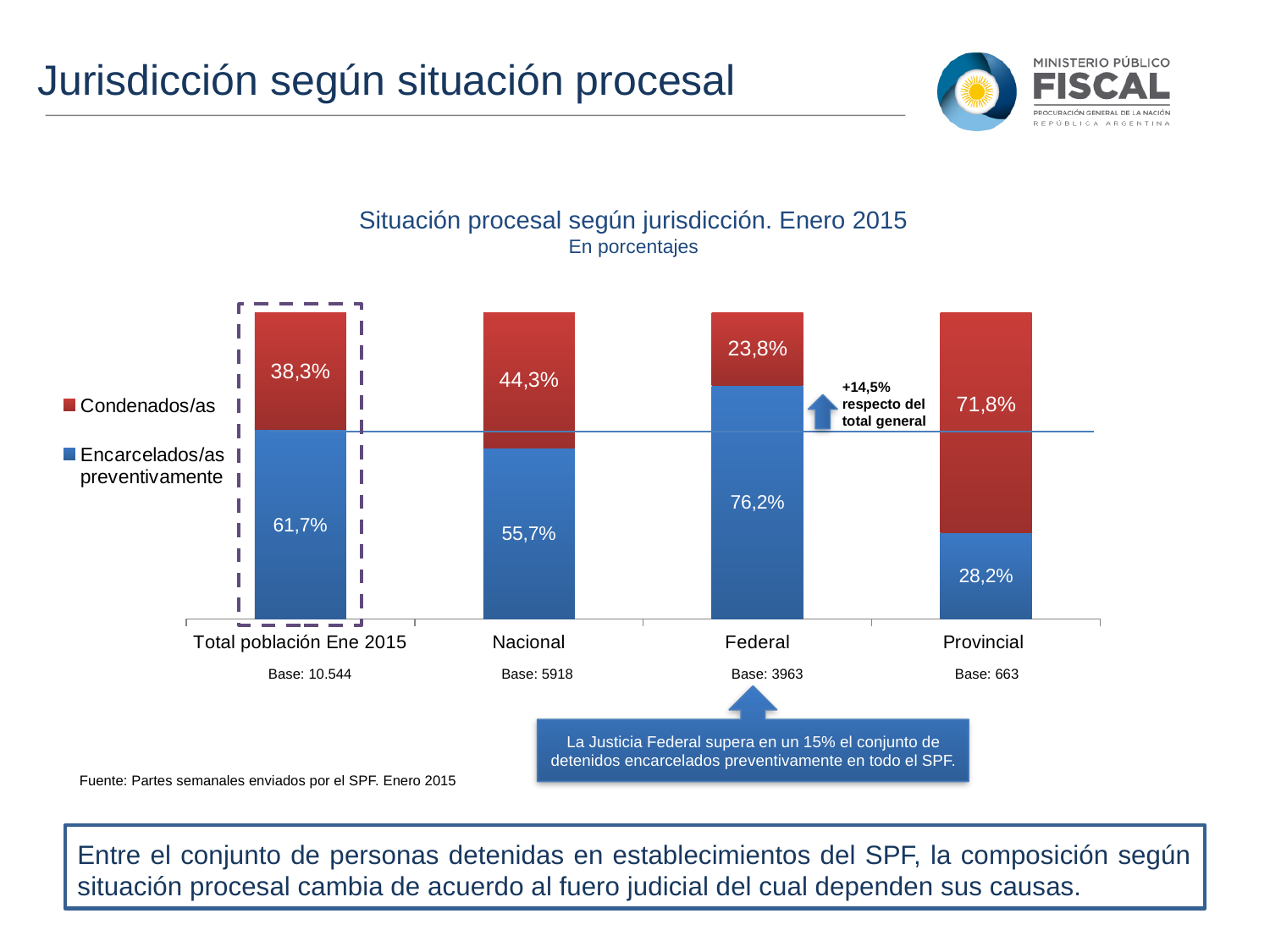
Which category has the highest value for Encarcelados/as preventivamente? Federal What is the base (number of cases) shown for the Federal category? 3963 What is the value for Encarcelados/as preventivamente in the Federal category? 76,2% What kind of chart is shown on the slide? Stacked bar chart What is the value for Condenados/as in the Nacional category? 44,3% What is the difference between the Encarcelados/as preventivamente values for Federal and Nacional? 20,5% How many series does the legend list? 2 What is the value for Condenados/as in the Provincial category? 71,8% Which is larger: Condenados/as in Provincial or Condenados/as in Nacional? Provincial What is the value for Encarcelados/as preventivamente in the Total población Ene 2015 category? 61,7% How many categories are shown on the x axis? 4 Which category has the lowest value for Condenados/as? Federal